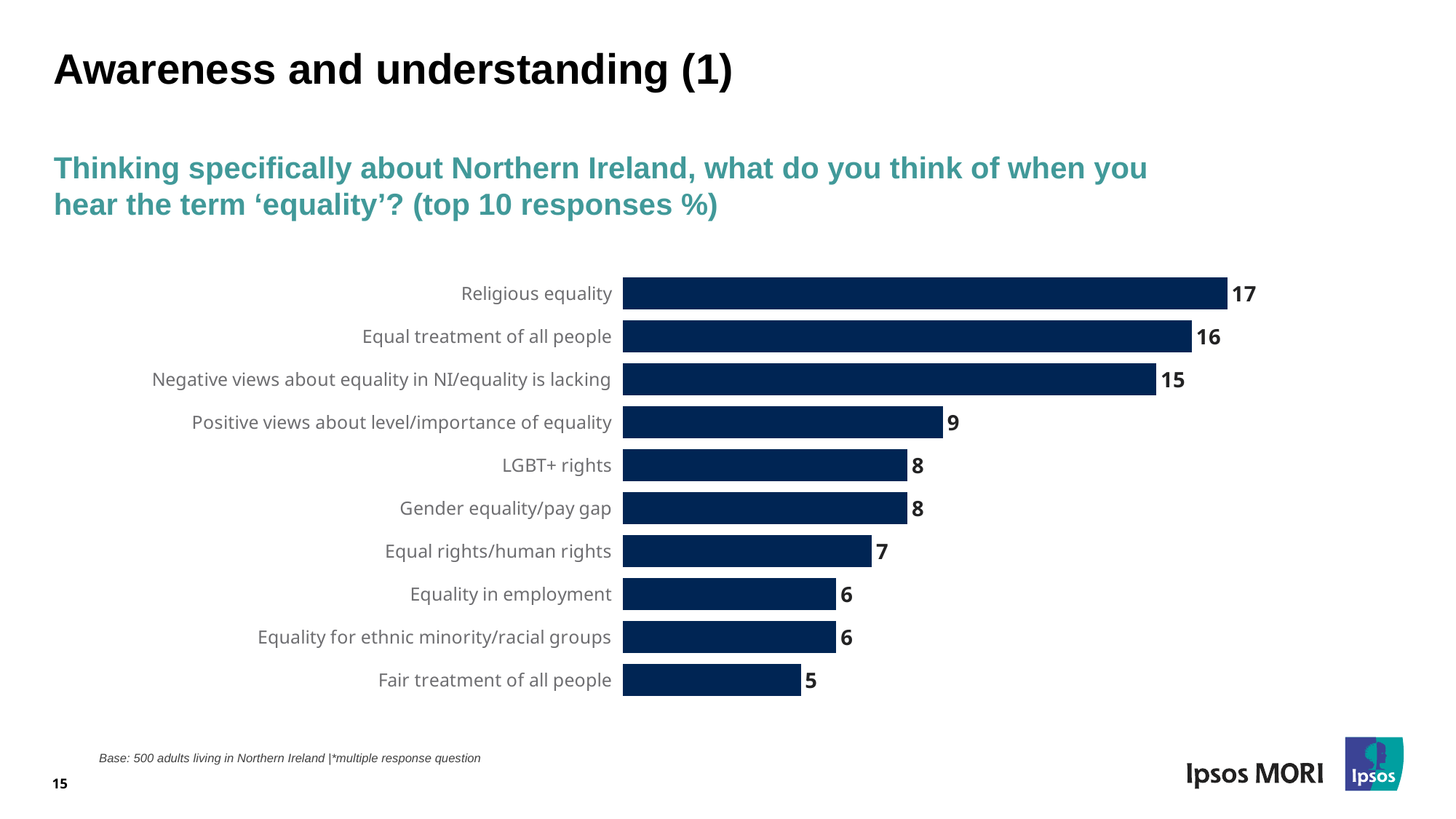
What is the base size stated below the chart? 500 adults living in Northern Ireland What is the value for LGBT+ rights? 8 What is the value for Equality in employment? 6 What is the value for Fair treatment of all people? 5 Which category has the highest value? Religious equality Which is larger, the value for Equal rights/human rights or the value for Gender equality/pay gap? Gender equality/pay gap Which category has the lowest value? Fair treatment of all people What kind of chart is shown on the slide? Bar chart What is the value for Religious equality? 17 What is the difference between the values for Negative views about equality in NI/equality is lacking and Positive views about level/importance of equality? 6 What is the difference between the values for Religious equality and Equal treatment of all people? 1 How many categories are shown in the chart? 10